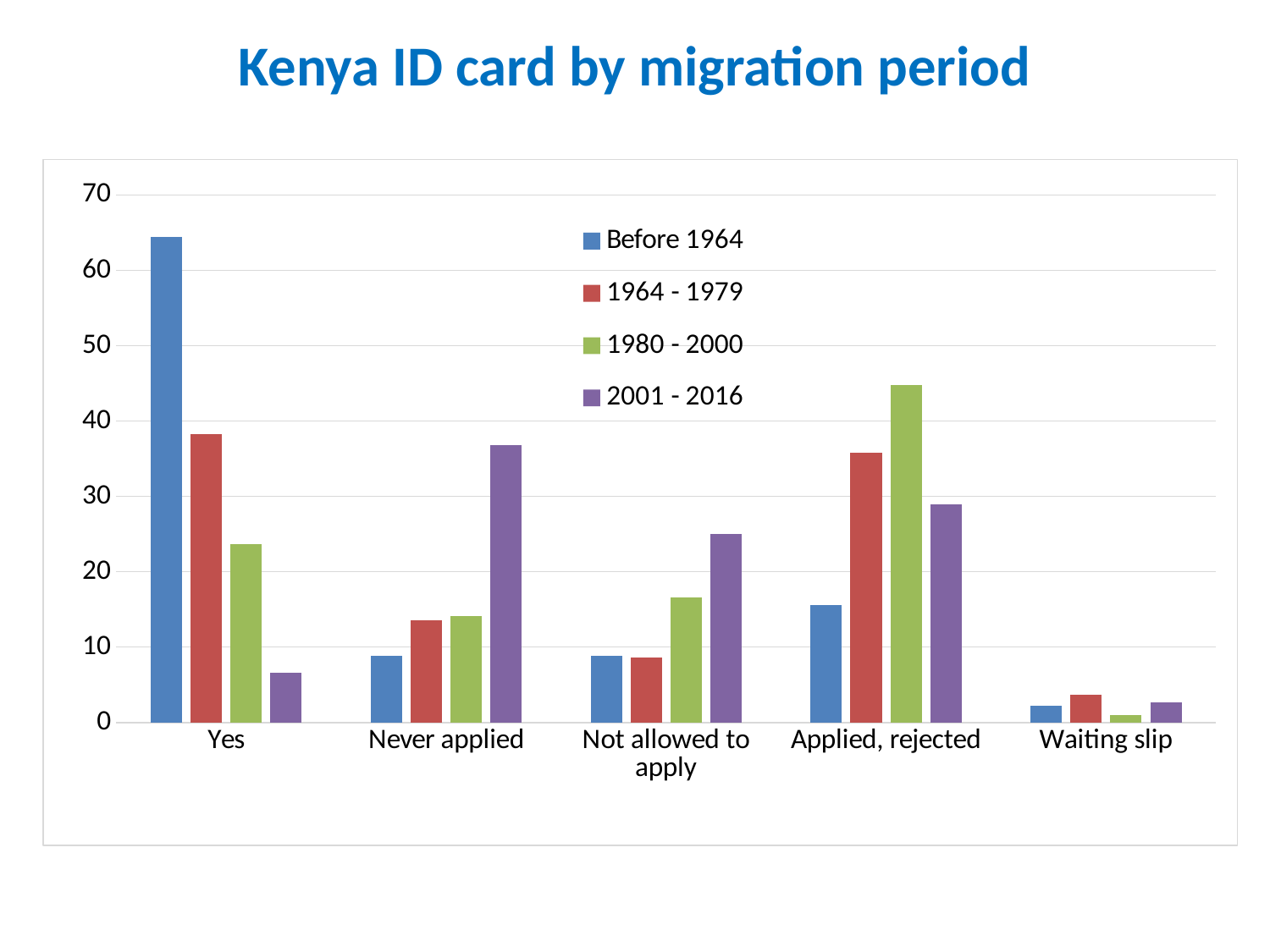
Is the value for 1980 - 2000 in the Not allowed to apply category greater or less than 20? less Is the value for 2001 - 2016 in the Never applied category greater or less than 30? greater Within the Applied, rejected category, which series has the highest bar? 1980 - 2000 Which category has the highest value for the Before 1964 series? Yes In the Never applied category, which is larger: 1980 - 2000 or 2001 - 2016? 2001 - 2016 In the Yes category, which is larger: Before 1964 or 1964 - 1979? Before 1964 Is the value for Before 1964 in the Yes category greater or less than 60? greater What is the title of the chart? Kenya ID card by migration period How many series does the legend list? 4 How many categories are shown on the x axis? 5 Which category has the lowest value for the 1980 - 2000 series? Waiting slip What kind of chart is shown on the slide? bar chart